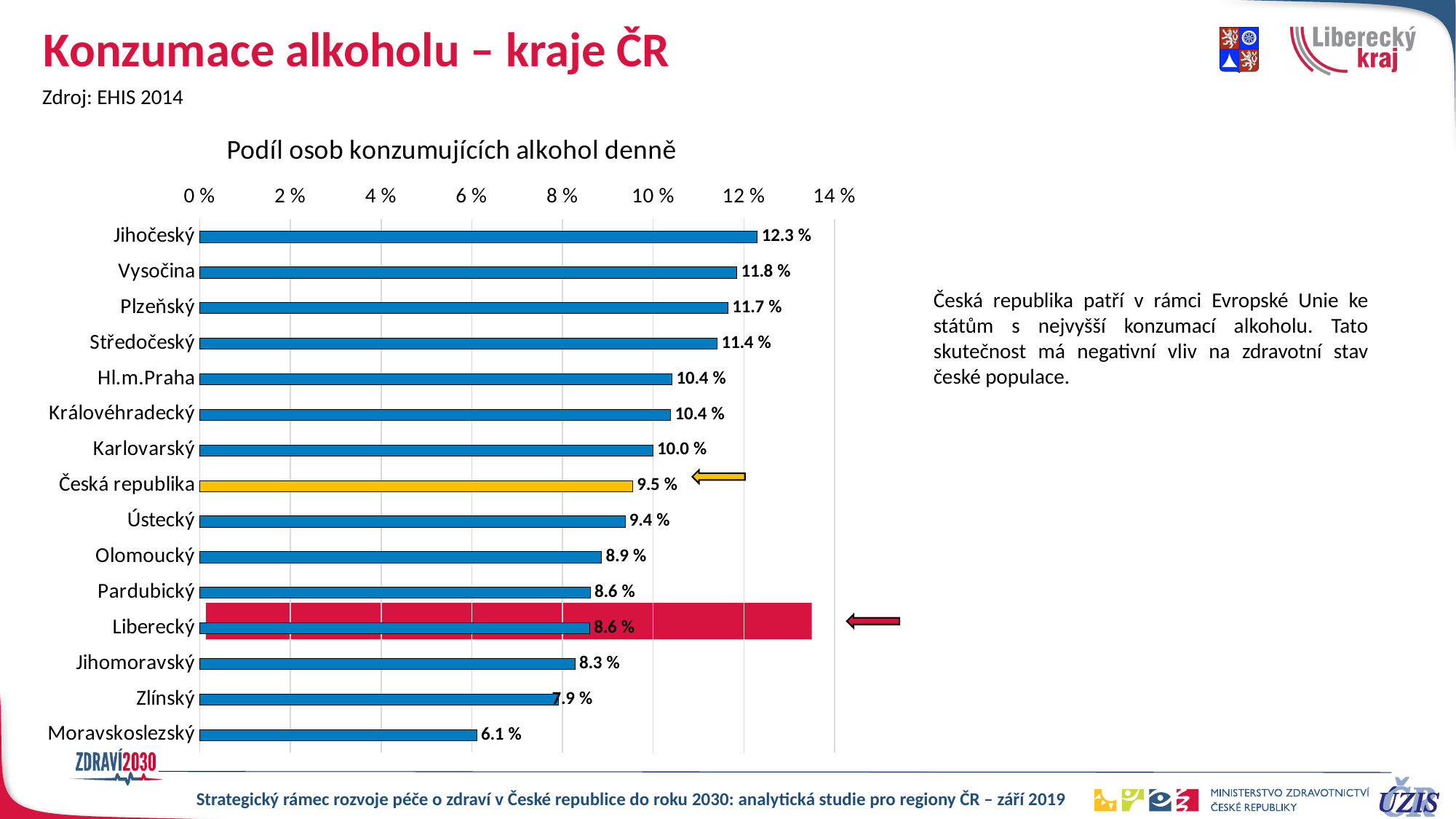
What is the value for Česká republika? 9.5 % What kind of chart is shown on the slide? bar chart What is the difference between the values for Jihočeský and Moravskoslezský? 6.2 % What is the value for Jihočeský? 12.3 % What is the title of the chart? Podíl osob konzumujících alkohol denně Which is larger, the value for Vysočina or the value for Karlovarský? Vysočina What is the value for Liberecký? 8.6 % Which category has the lowest value? Moravskoslezský How many categories are shown on the chart? 15 Which category has the highest value? Jihočeský Is the value for Středočeský greater or less than 10 %? greater Which category's bar is coloured yellow/orange instead of blue? Česká republika